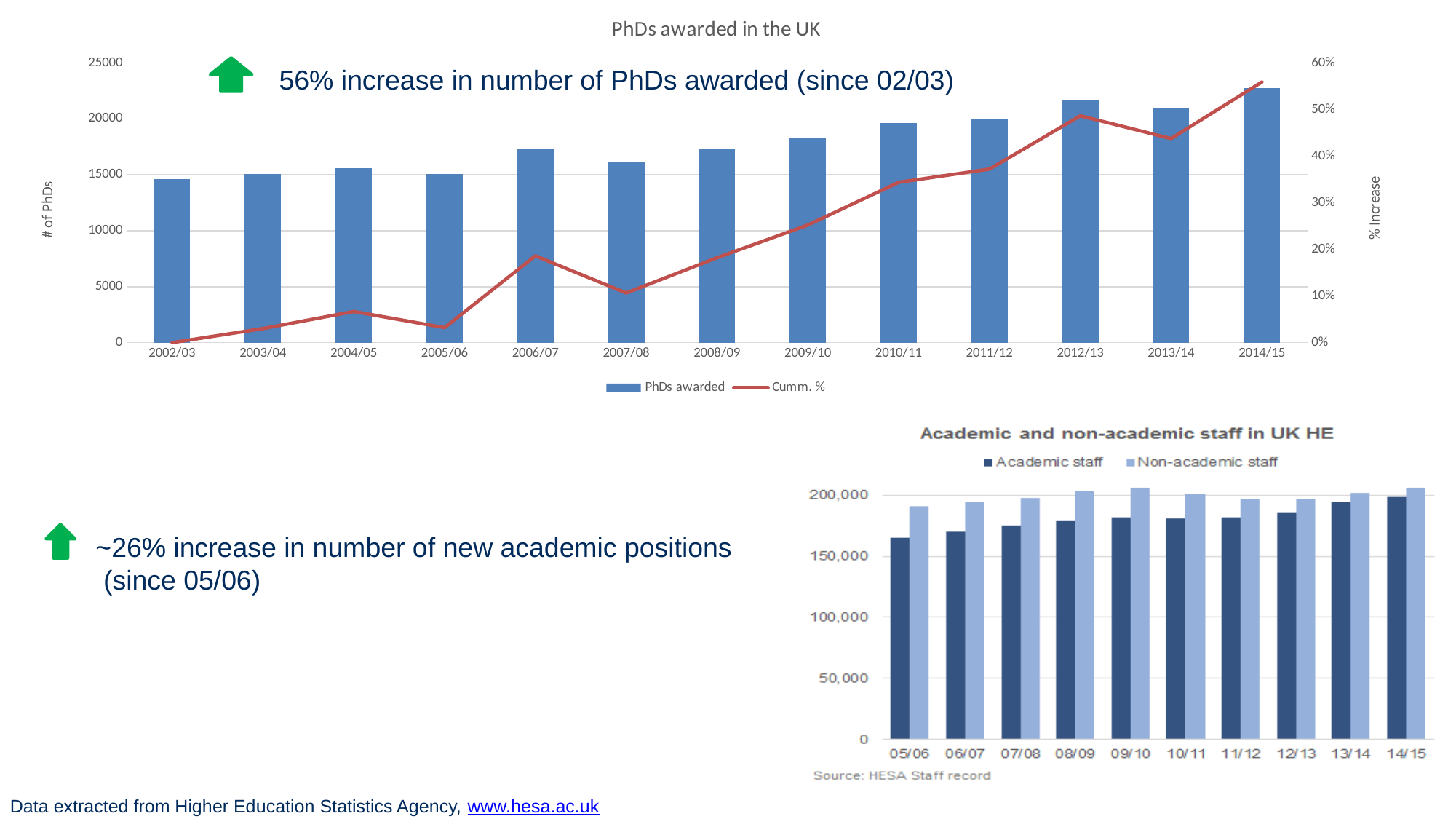
What type of chart is the 'PhDs awarded in the UK' chart? Combined bar and line chart In the 'Academic and non-academic staff in UK HE' chart, what source is cited below the chart? HESA Staff record In the 'Academic and non-academic staff in UK HE' chart, how many years are shown on the x axis? 10 In the 'Academic and non-academic staff in UK HE' chart, is the Academic staff value for 05/06 greater or less than 150,000? greater In the 'PhDs awarded in the UK' chart, does the Cumm. % line generally rise or fall from 2002/03 to 2014/15? rise In the 'PhDs awarded in the UK' chart, which year has the highest number of PhDs awarded? 2014/15 In the 'PhDs awarded in the UK' chart, how many academic years are shown on the x axis? 13 In the 'PhDs awarded in the UK' chart, is the number of PhDs awarded in 2014/15 greater or less than 20000? greater In the 'Academic and non-academic staff in UK HE' chart, which series is larger in 05/06, Academic staff or Non-academic staff? Non-academic staff In the 'PhDs awarded in the UK' chart, what is the label of the right-hand vertical axis? % Increase In the 'PhDs awarded in the UK' chart, is the Cumm. % value for 2007/08 greater or less than 20%? less In the 'PhDs awarded in the UK' chart, how many series does the legend list? 2